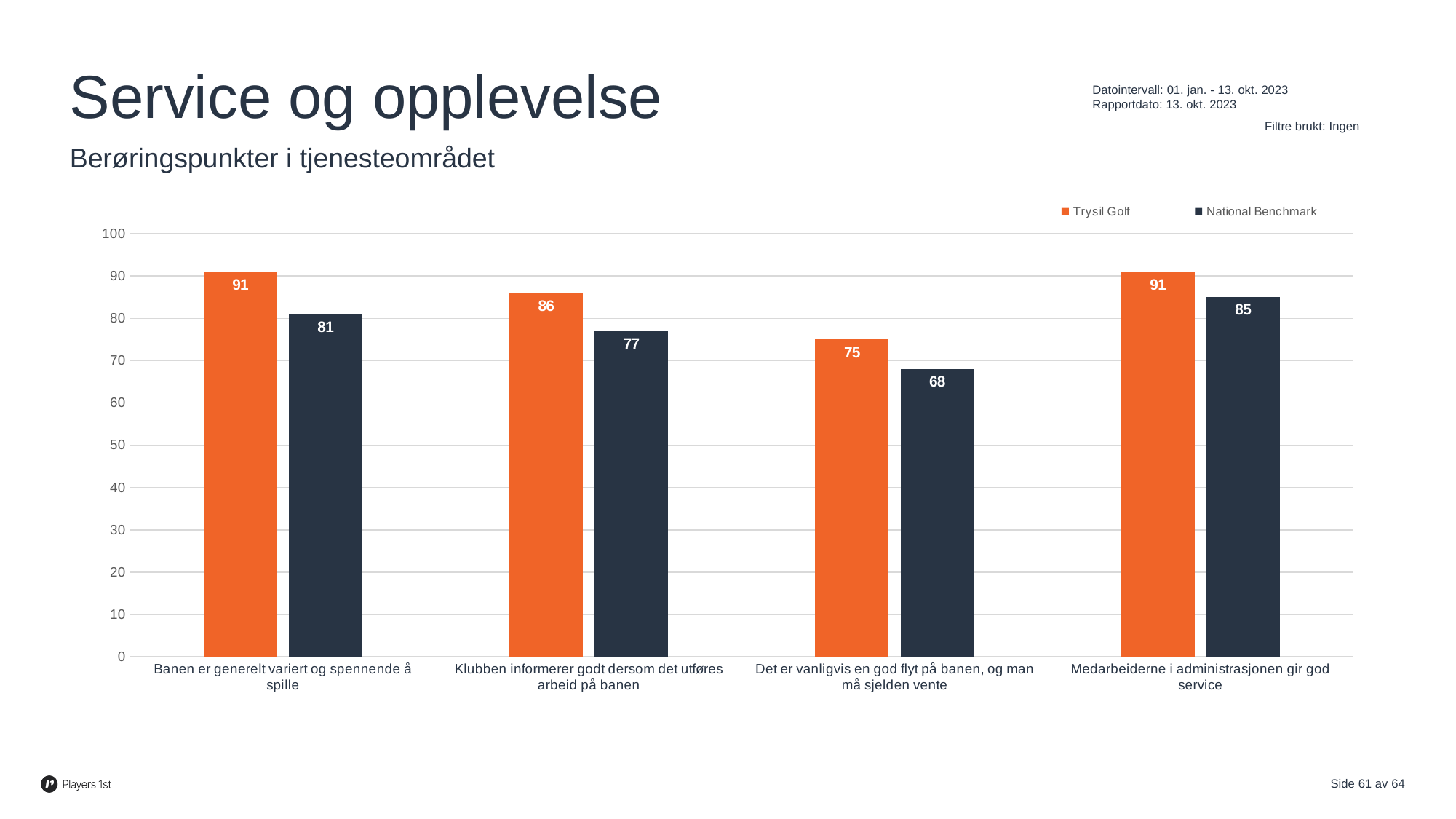
Is the National Benchmark value for "Banen er generelt variert og spennende å spille" greater or less than 90? less What is the Trysil Golf value for "Klubben informerer godt dersom det utføres arbeid på banen"? 86 What is the difference between the Trysil Golf and National Benchmark values for "Banen er generelt variert og spennende å spille"? 10 Which category has the highest National Benchmark value? Medarbeiderne i administrasjonen gir god service Which category has the lowest Trysil Golf value? Det er vanligvis en god flyt på banen, og man må sjelden vente What is the National Benchmark value for "Medarbeiderne i administrasjonen gir god service"? 85 What is the National Benchmark value for "Det er vanligvis en god flyt på banen, og man må sjelden vente"? 68 What kind of chart is shown on the slide? Bar chart What is the difference between the Trysil Golf and National Benchmark values for "Klubben informerer godt dersom det utføres arbeid på banen"? 9 Which is larger: the Trysil Golf value for "Det er vanligvis en god flyt på banen, og man må sjelden vente" or the National Benchmark value for the same category? Trysil Golf How many categories are shown on the x axis? 4 How many series does the legend list? 2